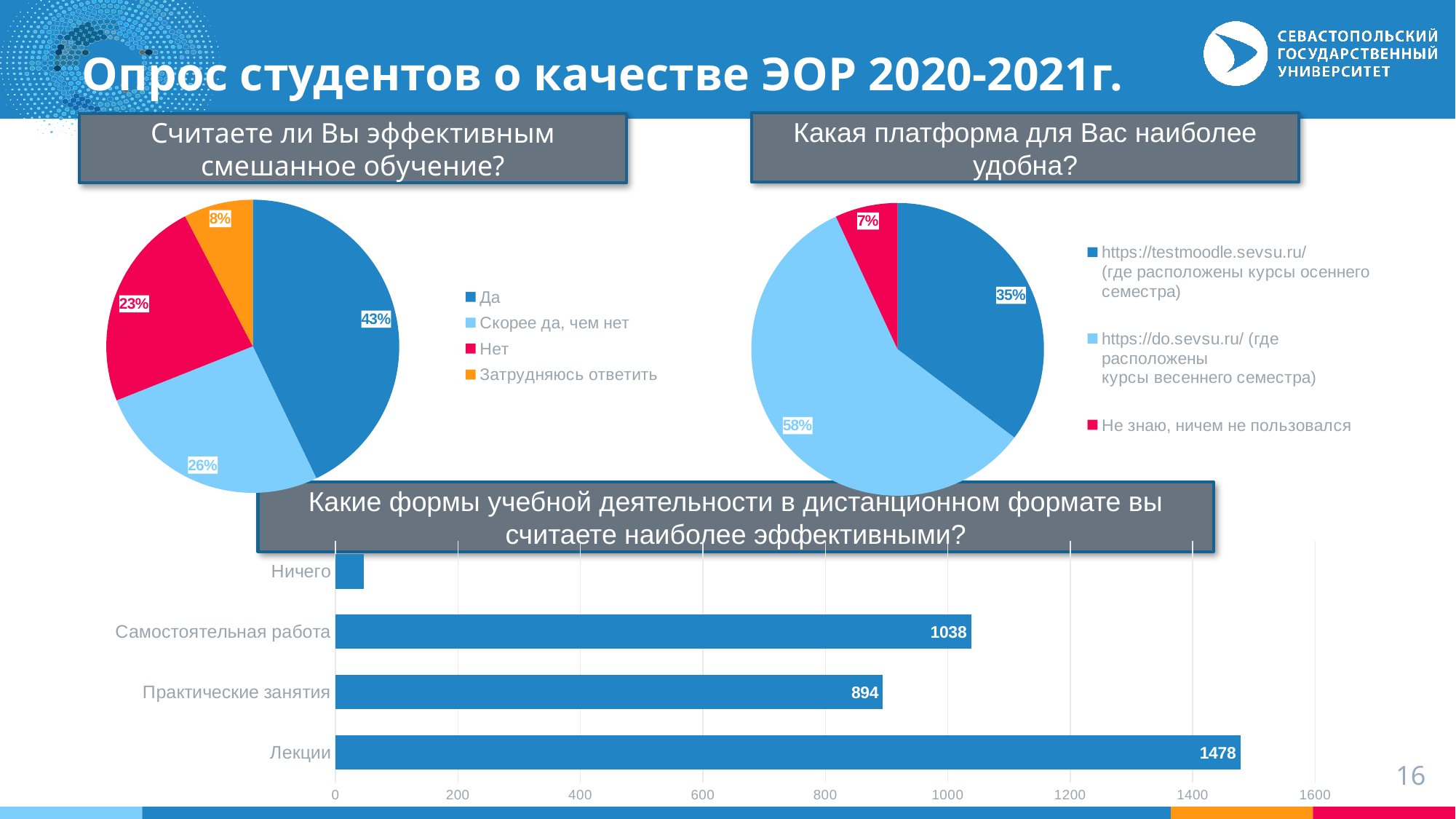
How many entries does the legend of the pie chart 'Считаете ли Вы эффективным смешанное обучение?' list? 4 In the pie chart 'Считаете ли Вы эффективным смешанное обучение?', what is the difference in percentage points between 'Скорее да, чем нет' and 'Нет'? 3 In the bar chart 'Какие формы учебной деятельности...', is the value for 'Ничего' greater or less than 200? less In the pie chart 'Какая платформа для Вас наиболее удобна?', what share answered 'Не знаю, ничем не пользовался'? 7% In the pie chart 'Какая платформа для Вас наиболее удобна?', which option has the largest share? https://do.sevsu.ru/ In the pie chart 'Считаете ли Вы эффективным смешанное обучение?', what share of respondents answered 'Да'? 43% In the bar chart 'Какие формы учебной деятельности...', what is the difference between 'Самостоятельная работа' and 'Практические занятия'? 144 In the pie chart 'Какая платформа для Вас наиболее удобна?', what share chose https://do.sevsu.ru/? 58% How many categories are shown in the bar chart 'Какие формы учебной деятельности...'? 4 In the pie chart 'Считаете ли Вы эффективным смешанное обучение?', which answer has the smallest share? Затрудняюсь ответить What type of chart is used for 'Какие формы учебной деятельности в дистанционном формате вы считаете наиболее эффективными?'? bar chart In the bar chart 'Какие формы учебной деятельности...', what is the value for 'Лекции'? 1478